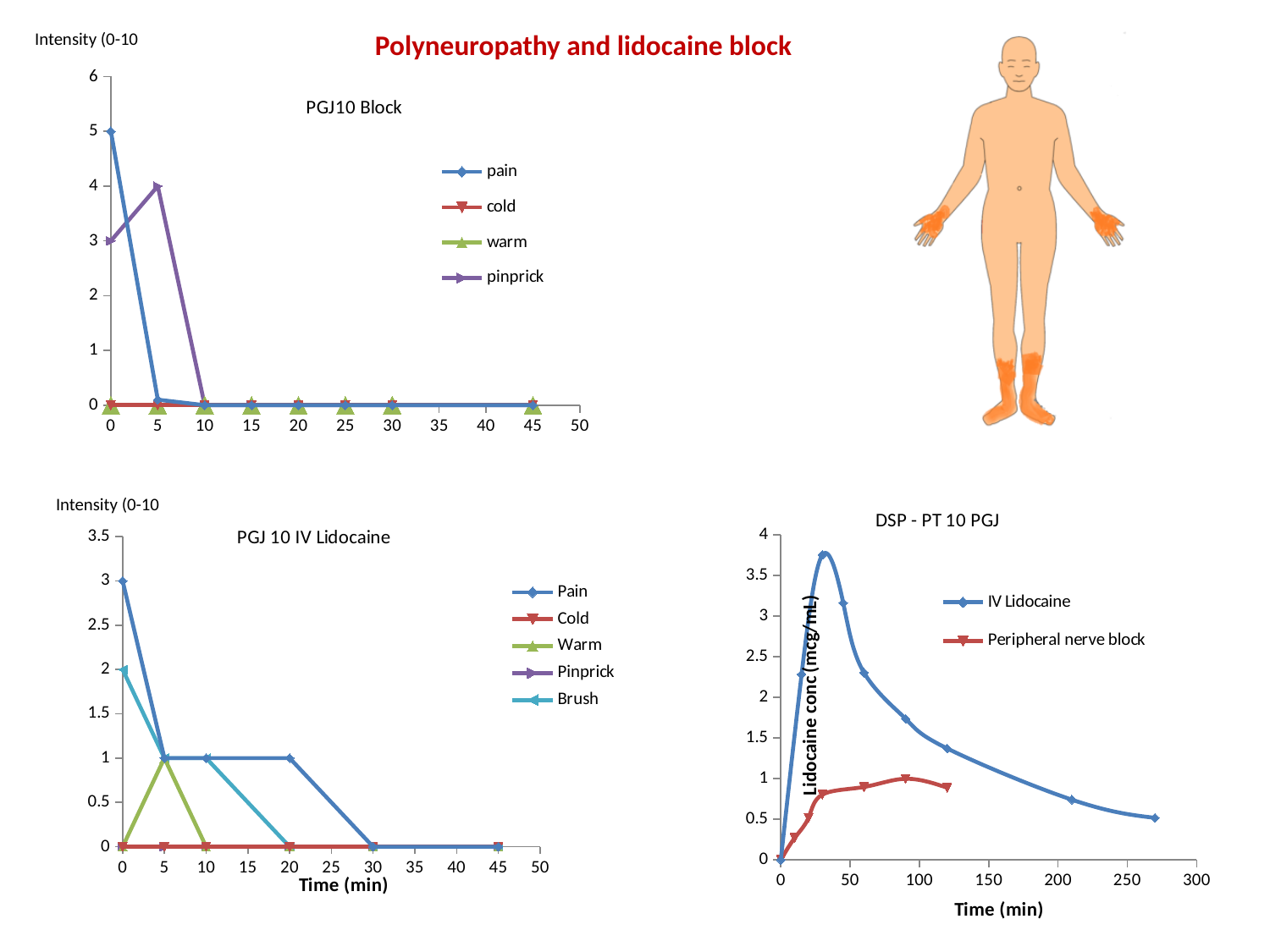
In the "PGJ 10 IV Lidocaine" chart, how many series does the legend list? 5 What type of chart is the "PGJ10 Block" chart? line chart In the "DSP - PT 10 PGJ" chart, does the IV Lidocaine concentration rise or fall between 50 and 250 minutes? fall In the "PGJ 10 IV Lidocaine" chart, what is the Brush intensity at 0 minutes? 2 In the "DSP - PT 10 PGJ" chart, is the peak value of IV Lidocaine greater or less than 3.5? greater In the "PGJ10 Block" chart, what is the pain intensity at 0 minutes? 5 In the "PGJ10 Block" chart, how many series does the legend list? 4 In the "PGJ 10 IV Lidocaine" chart, what is the Warm intensity at 5 minutes? 1 In the "PGJ10 Block" chart, what is the pinprick intensity at 5 minutes? 4 In the "DSP - PT 10 PGJ" chart, what is the label of the y axis? Lidocaine conc (mcg/mL) In the "PGJ 10 IV Lidocaine" chart, what is the Pain intensity at 0 minutes? 3 In the "PGJ10 Block" chart, which is larger at 0 minutes, pain or pinprick? pain